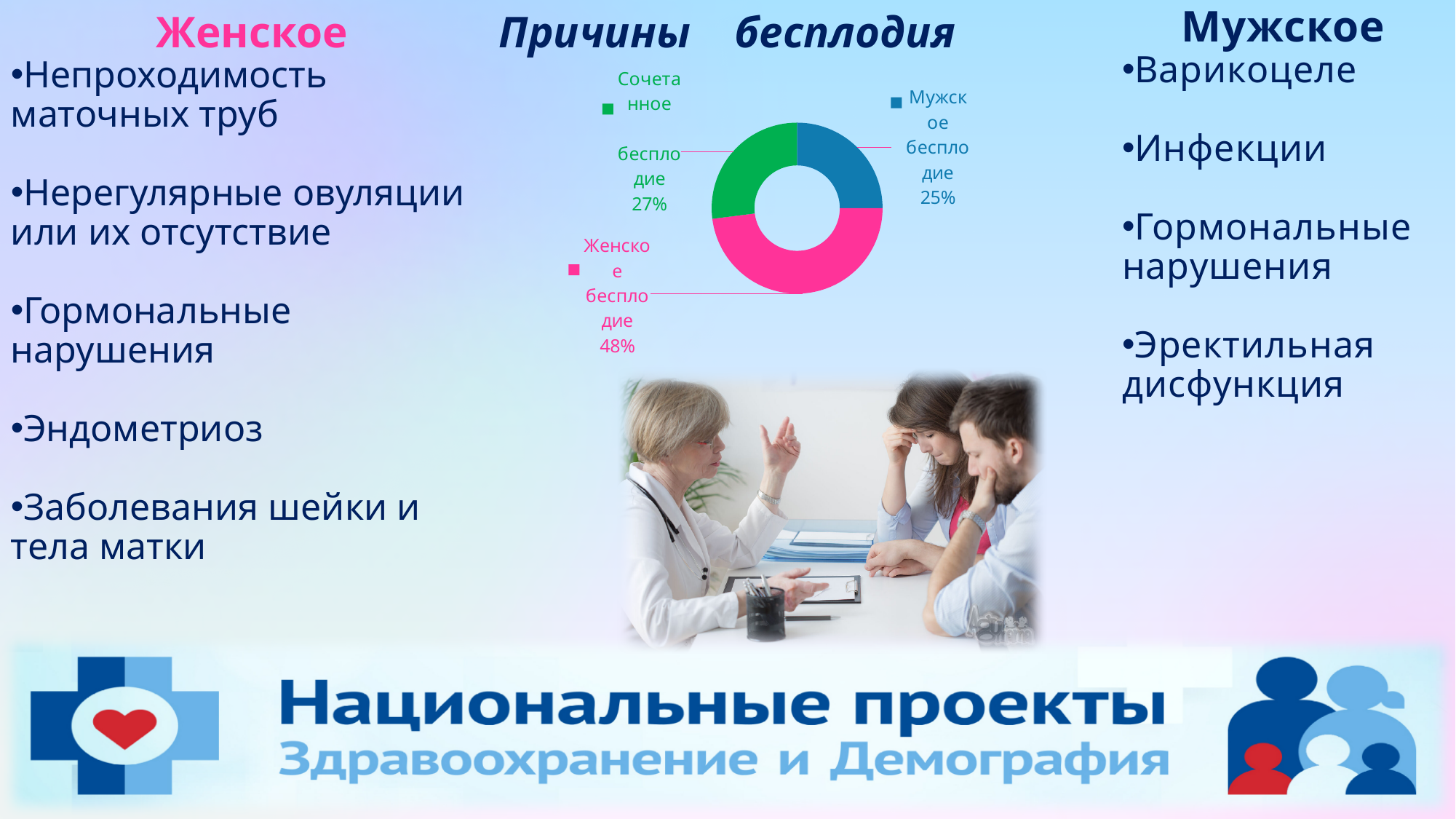
What share of the pie does Сочетанное бесплодие account for? 27% What kind of chart is shown on the slide? Doughnut chart What share of the pie does Женское бесплодие account for? 48% What share of the pie does Мужское бесплодие account for? 25% Which is larger, the share for Женское бесплодие or the share for Сочетанное бесплодие? Женское бесплодие How many slices does the pie chart have? 3 What is the difference in percentage points between Женское бесплодие and Мужское бесплодие? 23 What is the title of the chart? Причины бесплодия What colour is the slice for Женское бесплодие? Pink Which category has the largest share of the pie? Женское бесплодие What is the difference in percentage points between Сочетанное бесплодие and Мужское бесплодие? 2 Which category has the smallest share of the pie? Мужское бесплодие